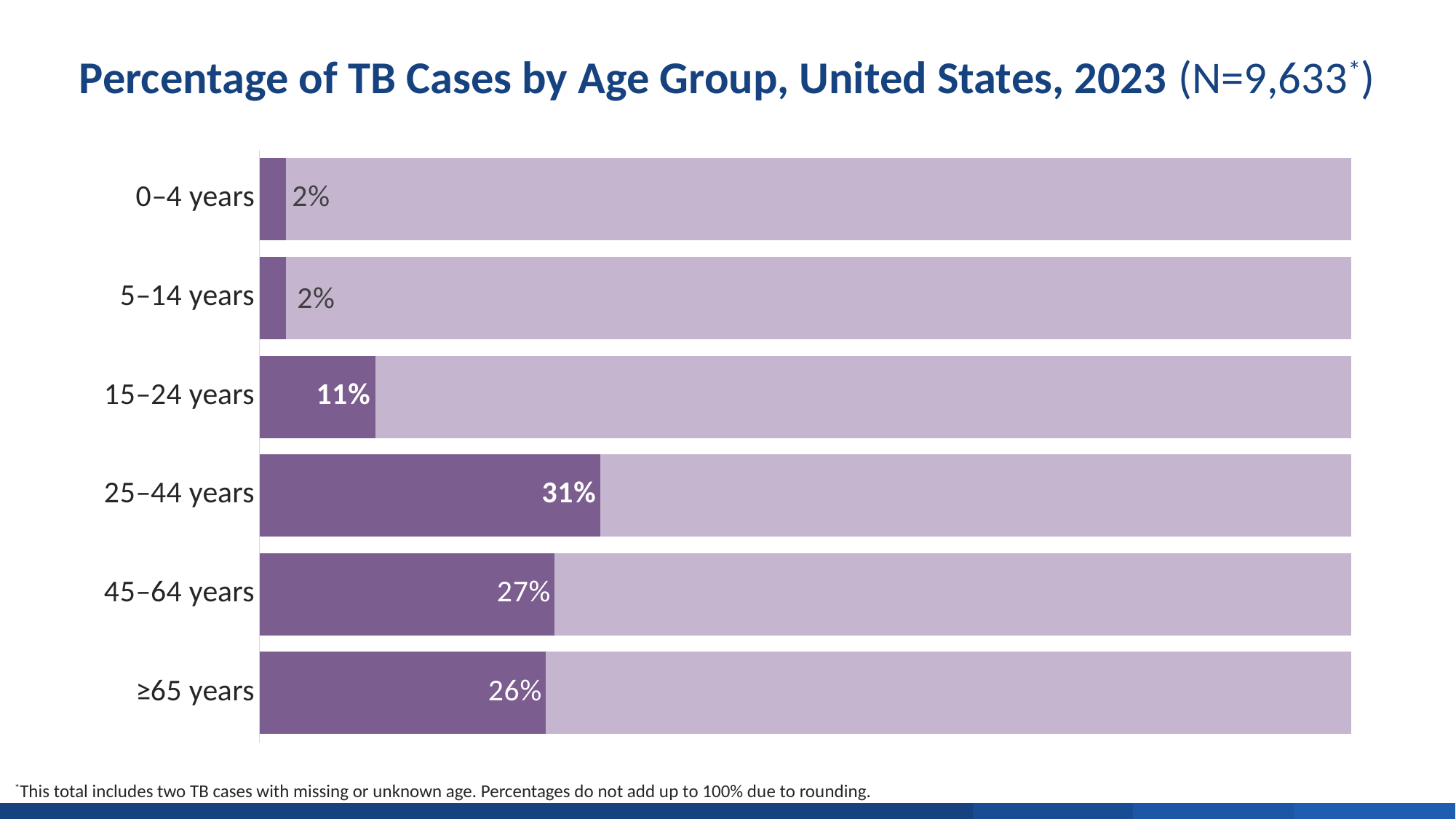
What is the difference in percentage points between the 15–24 years and 0–4 years age groups? 9 What percentage of TB cases were in the 25–44 years age group? 31% What percentage of TB cases were in the ≥65 years age group? 26% What percentage of TB cases were in the 15–24 years age group? 11% Which has a larger percentage of TB cases, the 45–64 years group or the ≥65 years group? 45–64 years Which age group has the highest percentage of TB cases? 25–44 years What is the difference in percentage points between the 25–44 years and 45–64 years age groups? 4 What kind of chart is shown on the slide? Bar chart Which has a larger percentage of TB cases, the 15–24 years group or the 25–44 years group? 25–44 years What is the total number of TB cases (N) given in the chart title? 9,633 What percentage of TB cases were in the 45–64 years age group? 27% How many age groups are shown in the chart? 6